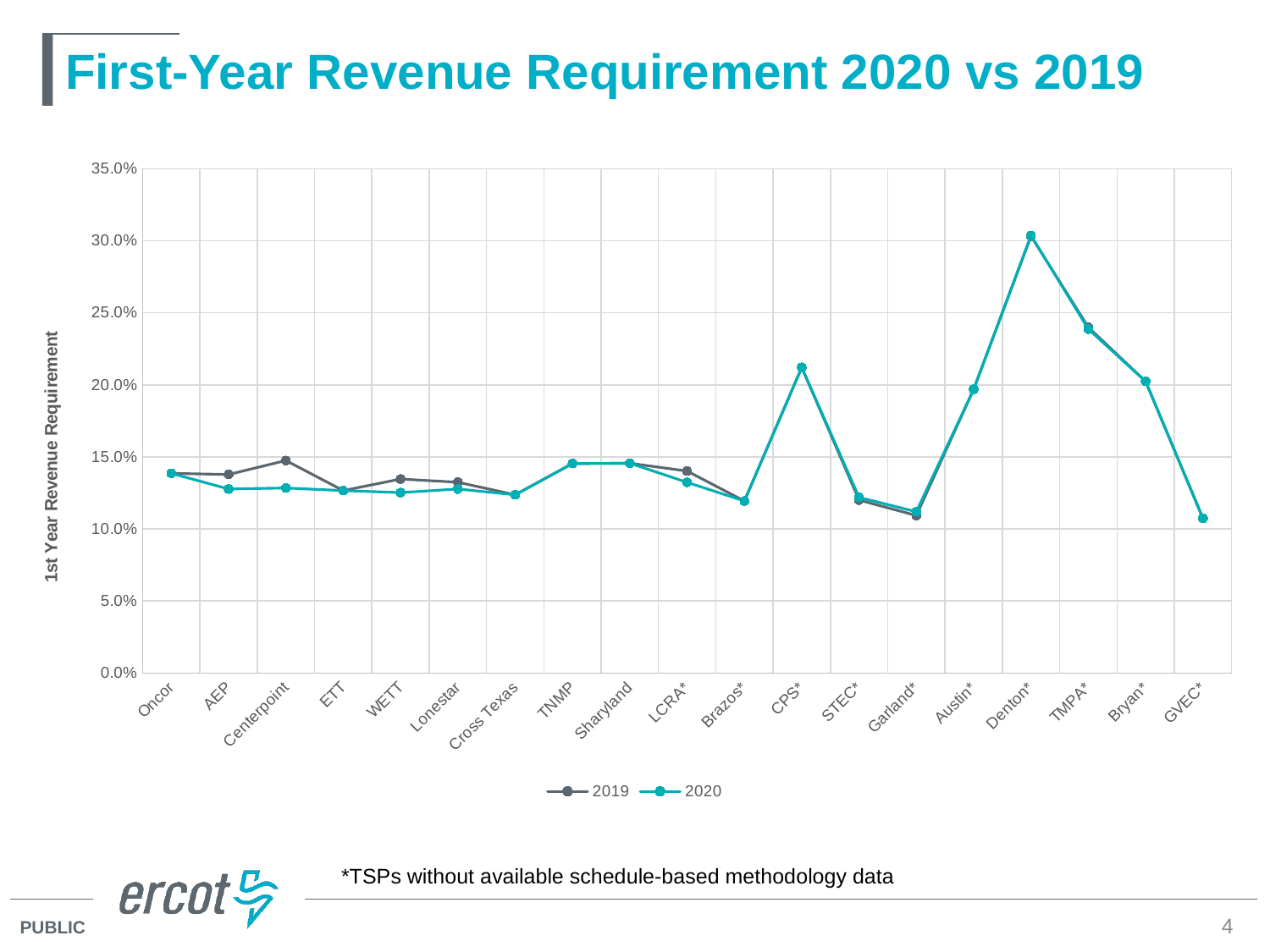
Do the 2020 values rise or fall from Denton* to GVEC*? fall Which category has the highest 2020 value? Denton* Which is larger for Centerpoint, the 2019 value or the 2020 value? 2019 How many series does the legend list? 2 Is the 2020 value for Denton* greater or less than 25.0%? greater Is the 2020 value for TMPA* greater or less than 20.0%? greater Which category has the lowest 2020 value? GVEC* How many categories are plotted along the x axis? 19 What kind of chart is shown on the slide? line chart Is the 2020 value for GVEC* greater or less than 15.0%? less What is the label of the y axis? 1st Year Revenue Requirement